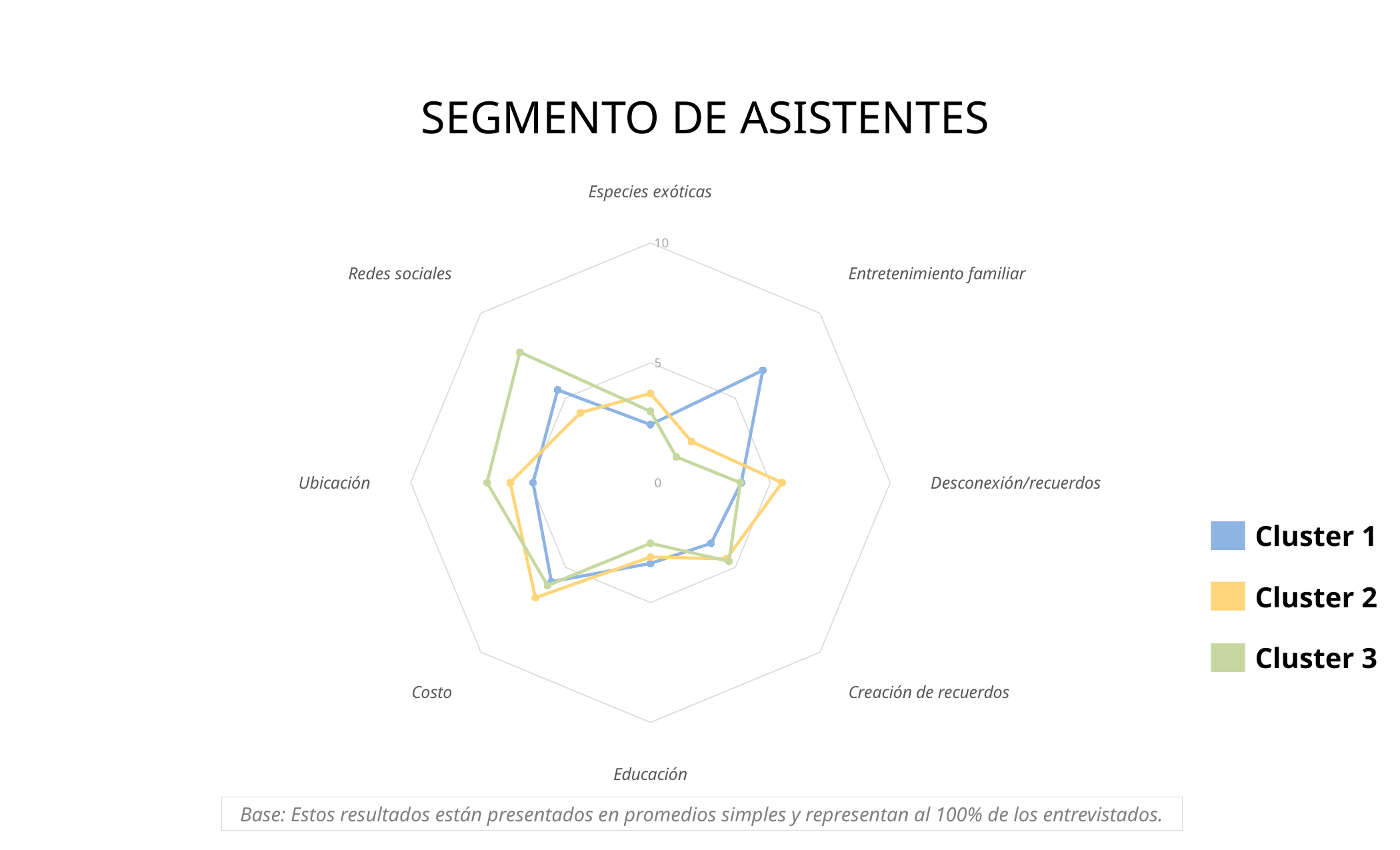
Is the value for Cluster 3 on Redes sociales greater or less than 5? greater What colour represents Cluster 2 in the legend? Yellow What kind of chart is shown on the slide? Radar chart On which category does Cluster 3 have its highest value? Redes sociales How many categories (axes) does the radar chart have? 8 On which category does Cluster 3 have its lowest value? Entretenimiento familiar Is the value for Cluster 1 on Entretenimiento familiar greater or less than 5? greater On Entretenimiento familiar, which is larger: Cluster 1 or Cluster 3? Cluster 1 Is the value for Cluster 2 on Costo greater or less than 5? greater How many series does the legend list? 3